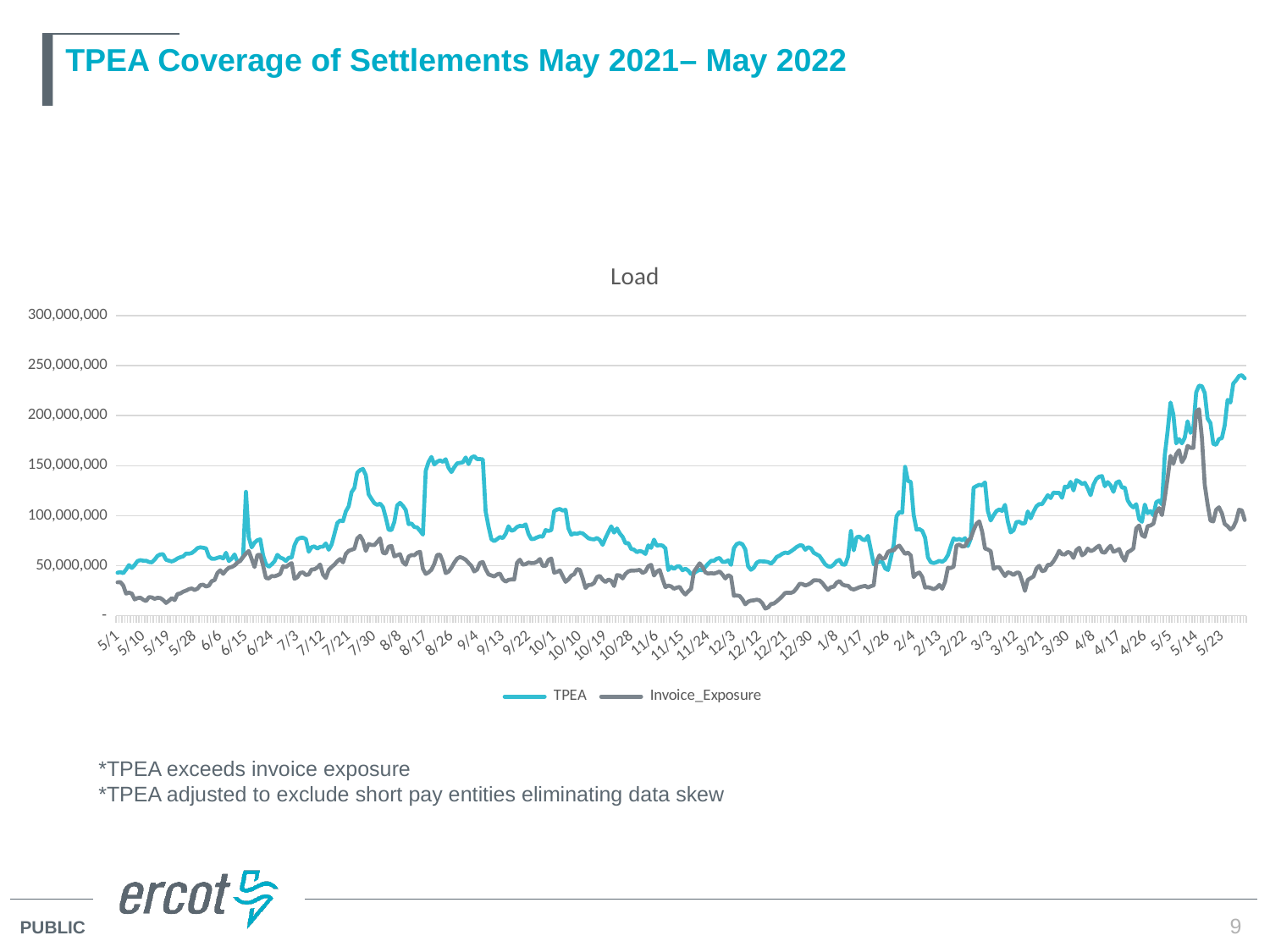
What kind of chart is shown on the slide? line chart What is the title of the chart? Load Is the Invoice_Exposure value at 12/12 greater or less than 50,000,000? less Does the Invoice_Exposure line rise or fall between 5/14 and 5/23? fall Which series is higher at 5/23, TPEA or Invoice_Exposure? TPEA Is the highest TPEA value on the chart greater or less than 250,000,000? less How many series does the chart's legend list? 2 Which series is drawn in the blue line? TPEA Is the peak Invoice_Exposure value around 5/14 greater or less than 150,000,000? greater Which series reaches the highest value anywhere on the chart? TPEA